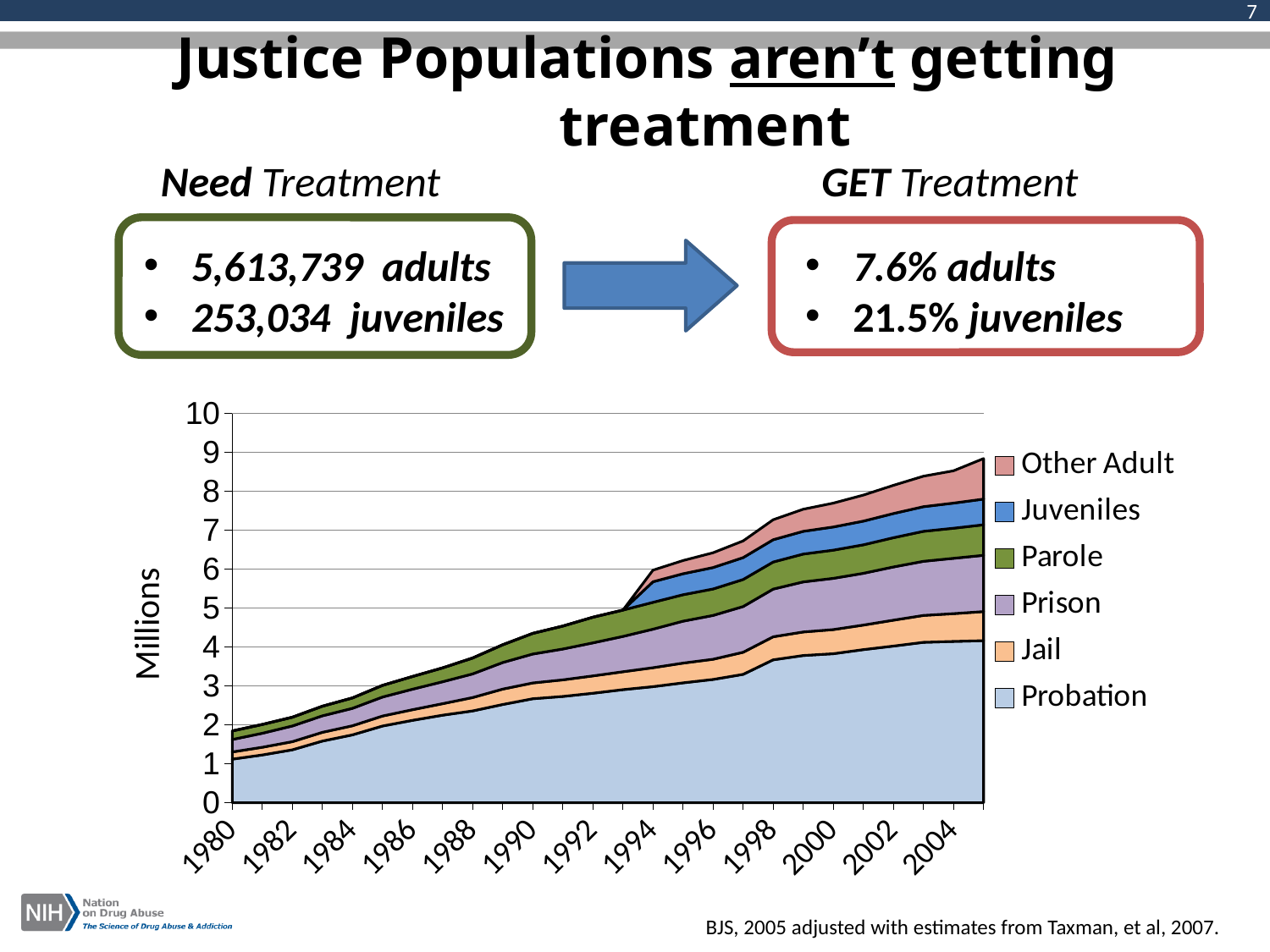
Is the total justice population in 1980 greater or less than 3 million? less How many series does the chart's legend list? 6 Is the total justice population in 2004 greater or less than 8 million? greater How many year labels are shown on the x axis? 13 What is the label on the chart's y axis? Millions Which series accounts for the largest share of the justice population across the chart? Probation Is the Probation value in 1996 greater or less than 4 million? less Which series is listed first (at the top) in the chart's legend? Other Adult What kind of chart is shown on the slide? Stacked area chart Does the total justice population rise or fall from 1980 to 2004? Rise